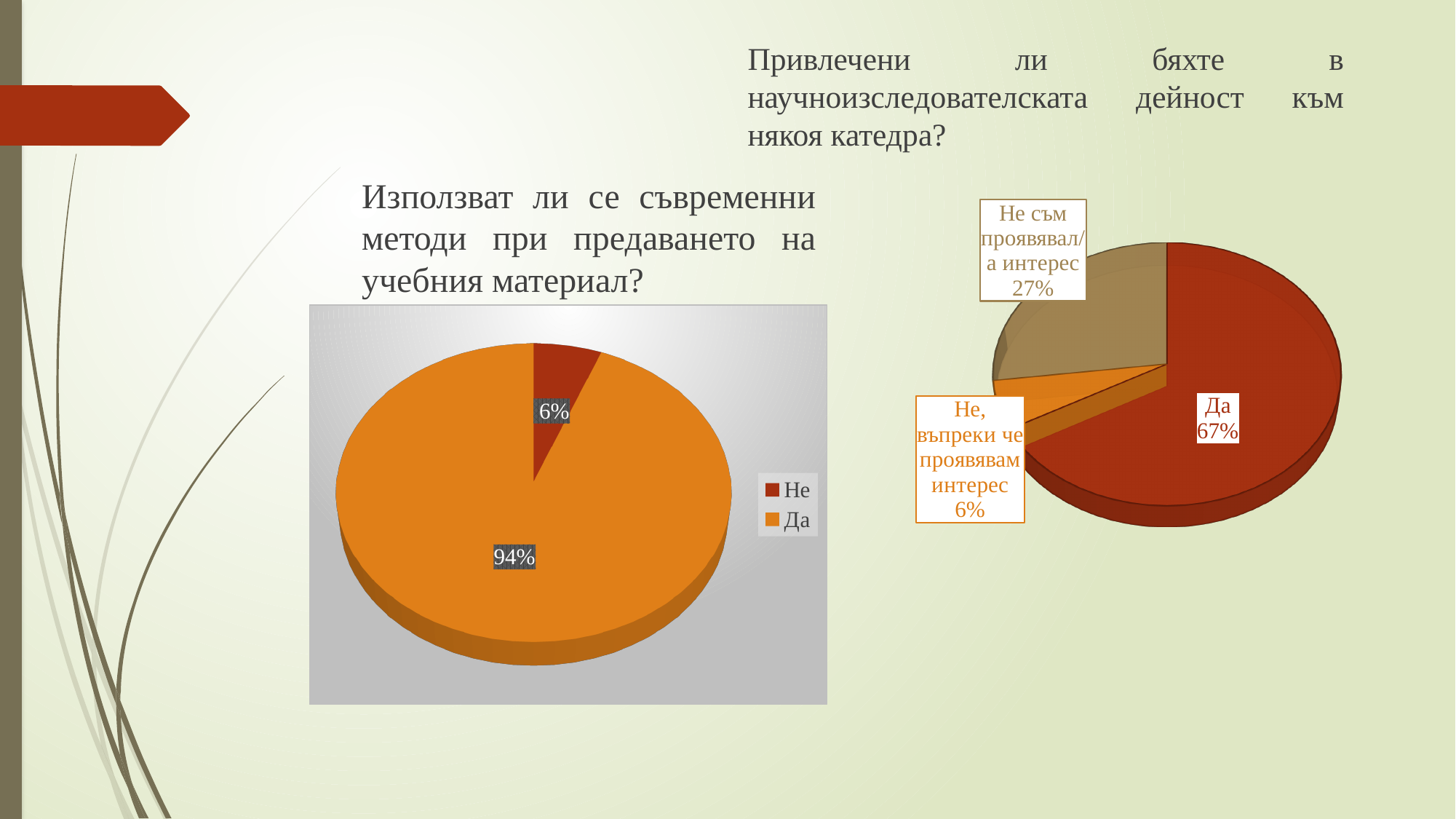
In the left pie chart, what share is labelled for "Не"? 6% How many slices does the right pie chart have? 3 In the right pie chart, which is larger: "Да" or "Не съм проявявал/а интерес"? Да In the right pie chart, what share is labelled for "Не съм проявявал/а интерес"? 27% In the right pie chart, which category has the smallest slice? Не, въпреки че проявявам интерес In the left pie chart ("Използват ли се съвременни методи при предаването на учебния материал?"), what share is labelled for "Да"? 94% What type of chart is shown on the left of the slide? Pie chart In the left pie chart, which category has the largest slice? Да How many entries does the legend of the left pie chart list? 2 In the right pie chart ("Привлечени ли бяхте в научноизследователската дейност към някоя катедра?"), what share is labelled for "Да"? 67% In the left pie chart, what is the difference in percentage points between "Да" and "Не"? 88 In the right pie chart, what share is labelled for "Не, въпреки че проявявам интерес"? 6%